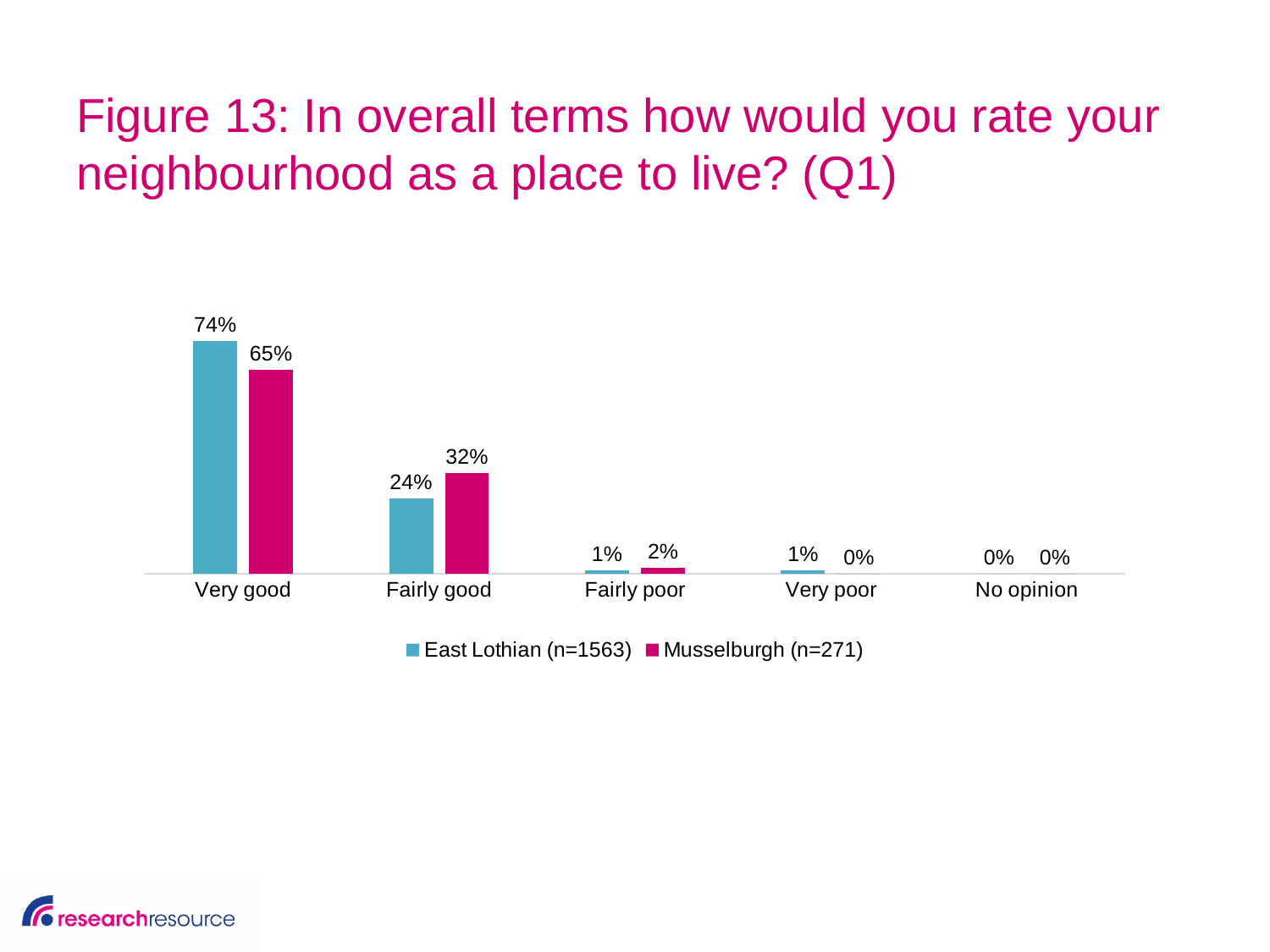
What is the difference between the East Lothian and Musselburgh values for Very good? 9 percentage points Which is larger for Fairly good: East Lothian or Musselburgh? Musselburgh Which is larger for Very good: East Lothian or Musselburgh? East Lothian What kind of chart is shown on the slide? Bar chart What is the sample size for Musselburgh shown in the legend? n=271 How many series does the legend list? 2 Which category has the highest value for East Lothian? Very good What is the difference between the Musselburgh and East Lothian values for Fairly good? 8 percentage points How many response categories are shown on the x axis? 5 What percentage of East Lothian respondents rated their neighbourhood as Very good? 74% What is the Musselburgh value for Very poor? 0% What percentage of Musselburgh respondents rated their neighbourhood as Fairly good? 32%